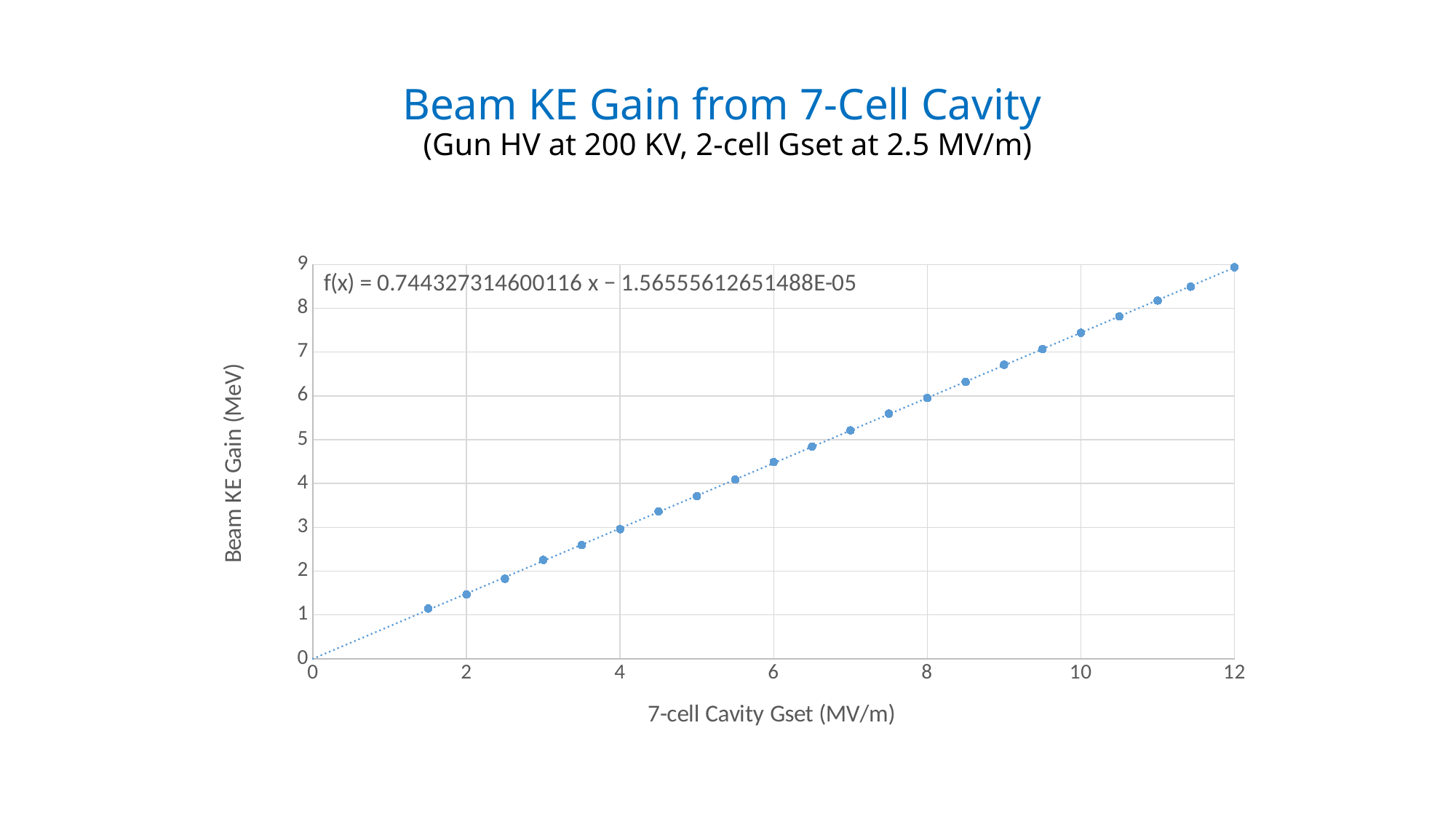
Does the beam KE gain rise or fall as the 7-cell cavity Gset increases? Rises What is the slope of the fitted line shown in the equation on the chart? 0.744327314600116 What is the title of the chart? Beam KE Gain from 7-Cell Cavity How many data points are plotted on the chart? 22 What is the label of the y axis? Beam KE Gain (MeV) Is the beam KE gain at a Gset of 12 MV/m greater or less than 8 MeV? greater Is the beam KE gain at a Gset of 6 MV/m greater or less than 4 MeV? greater Is the beam KE gain at a Gset of 6 MV/m greater or less than 5 MeV? less What kind of chart is shown on the slide? Scatter plot Which Gset value has the highest beam KE gain, 12 MV/m or 2 MV/m? 12 MV/m